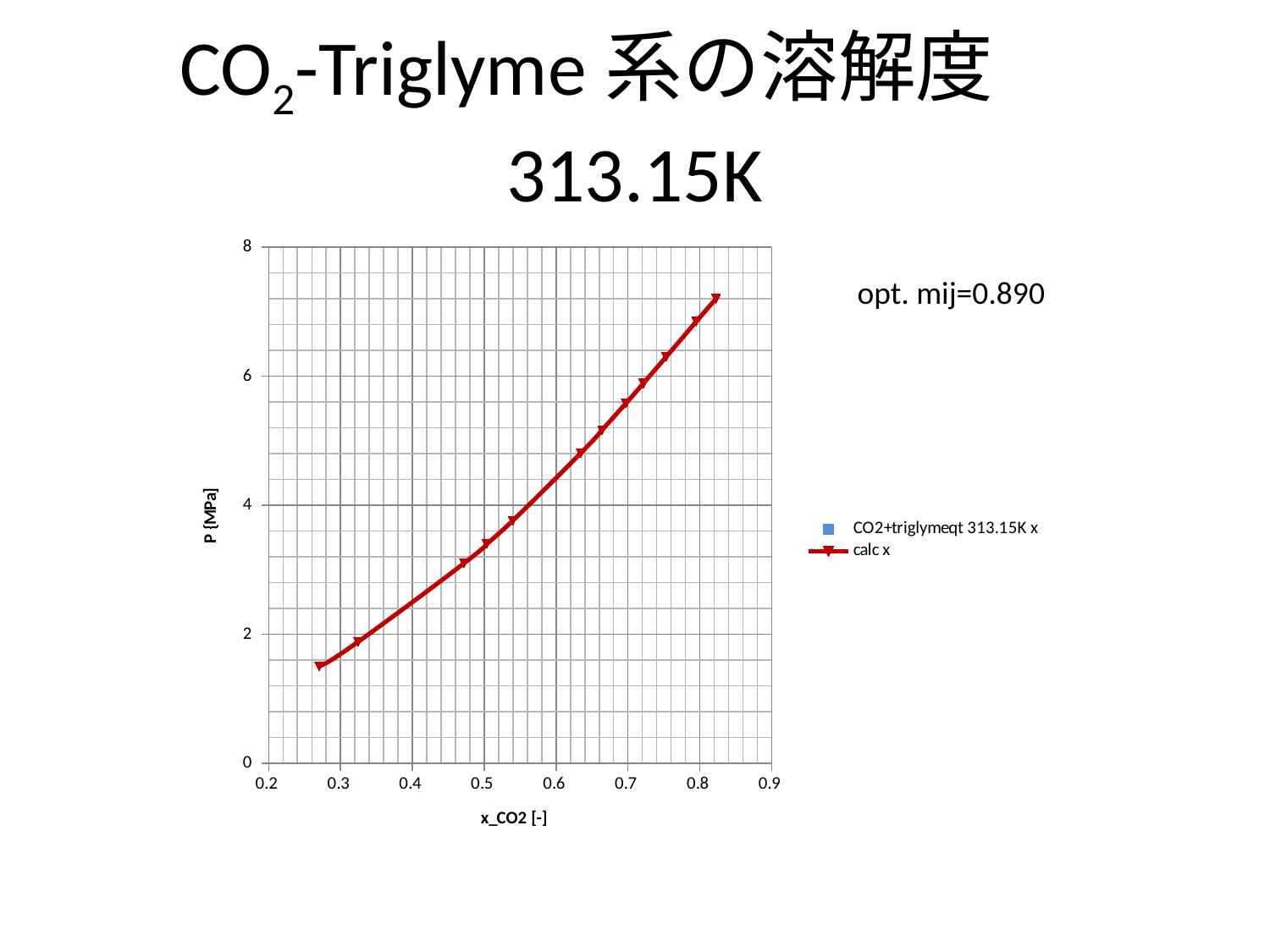
Is the value of P for the calc x series at x_CO2 = 0.5 greater or less than 4? less Is the value of P for the calc x series at x_CO2 = 0.7 greater or less than 4? greater What kind of chart is shown on the slide? line chart What is the label of the x axis of the chart? x_CO2 [-] How many series does the chart legend list? 2 Which point of the calc x series has the highest P: the one near x_CO2 = 0.27 or the one near x_CO2 = 0.82? the one near x_CO2 = 0.82 Is the value of P for the rightmost point of the calc x series (near x_CO2 = 0.82) greater or less than 6? greater What is the label of the y axis of the chart? P [MPa] What is the highest value shown on the y axis of the chart? 8 Does the pressure P rise or fall as x_CO2 increases along the x axis? rise